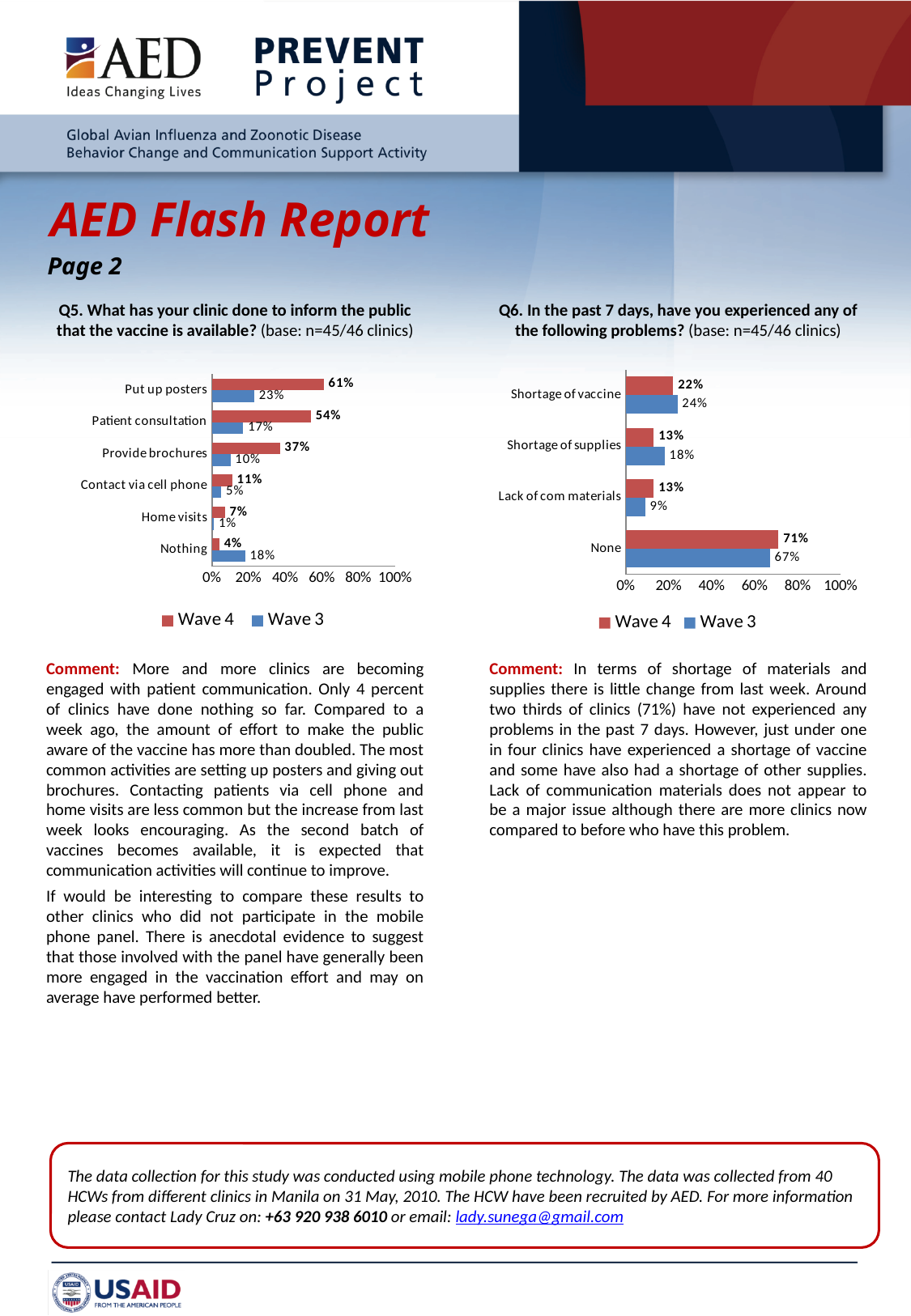
In the Q5 chart, which category has the highest Wave 4 value? Put up posters In the Q6 chart, what is the Wave 4 value for None? 71% In the Q5 chart, how many categories are shown? 6 In the Q6 chart, what is the difference between the Wave 4 and Wave 3 values for Shortage of supplies? 5% In the Q6 chart, what is the Wave 3 value for Shortage of vaccine? 24% In the Q5 chart, which category has the lowest Wave 3 value? Home visits In the Q5 chart, what is the Wave 4 value for Put up posters? 61% In the Q6 chart, which is larger for Lack of com materials: Wave 4 or Wave 3? Wave 4 In the Q5 chart, what is the difference between the Wave 4 and Wave 3 values for Patient consultation? 37% What type of chart is the Q6 chart? Bar chart In the Q5 chart, what is the Wave 3 value for Nothing? 18% In the Q6 chart, how many series does the legend list? 2